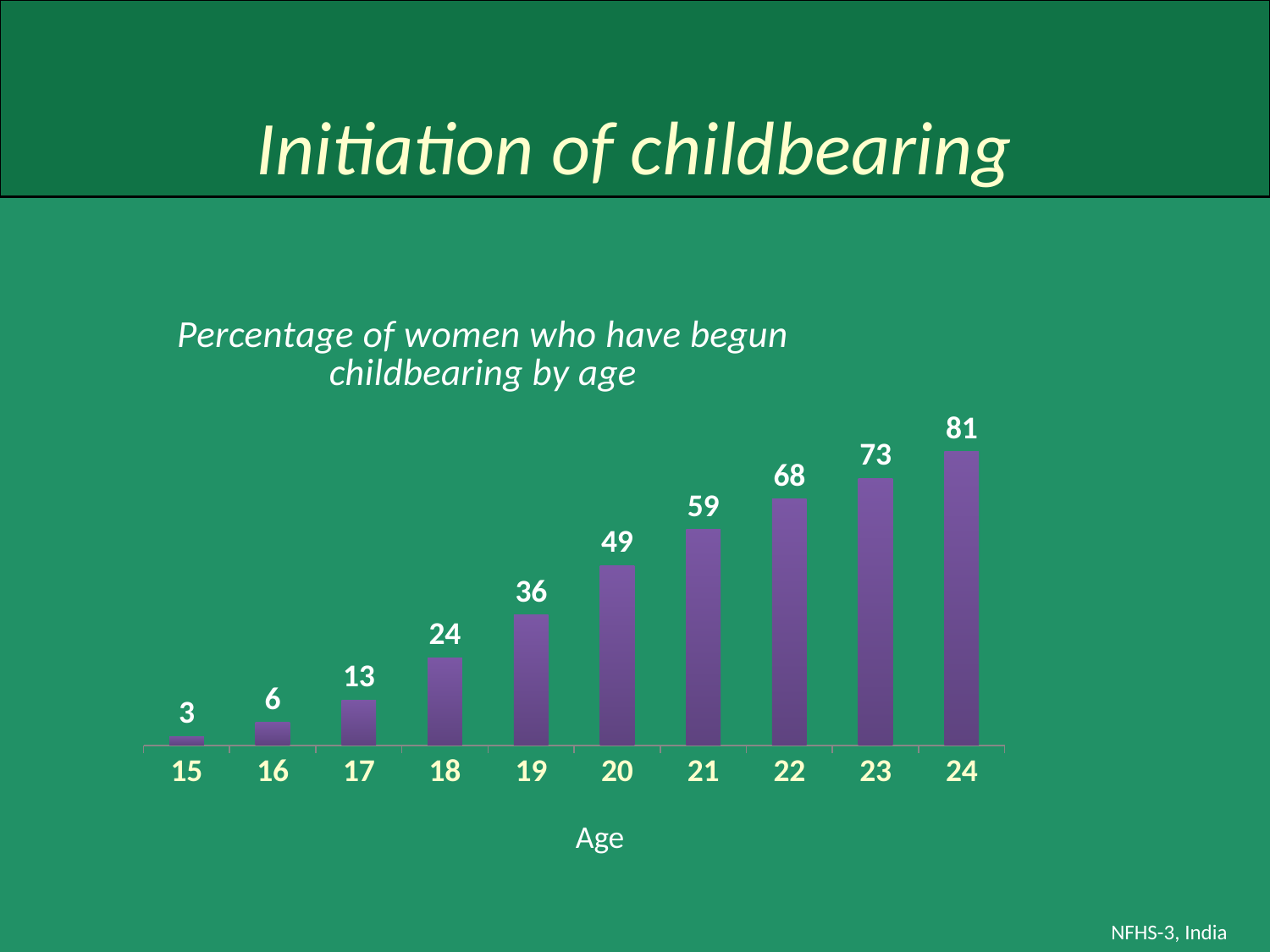
Which age has the highest percentage of women who have begun childbearing? 24 What is the difference between the values for age 19 and age 17? 23 Which age has the lowest value on the chart? 15 What is the difference between the values for age 24 and age 20? 32 Which is larger, the value for age 22 or the value for age 23? age 23 What is the label of the x axis? Age What is the value shown for age 21? 59 Do the values rise or fall as age increases along the x axis? rise How many age categories are shown on the x axis? 10 What percentage of women have begun childbearing by age 18? 24 What is the value shown for age 15? 3 What kind of chart is shown on the slide? bar chart